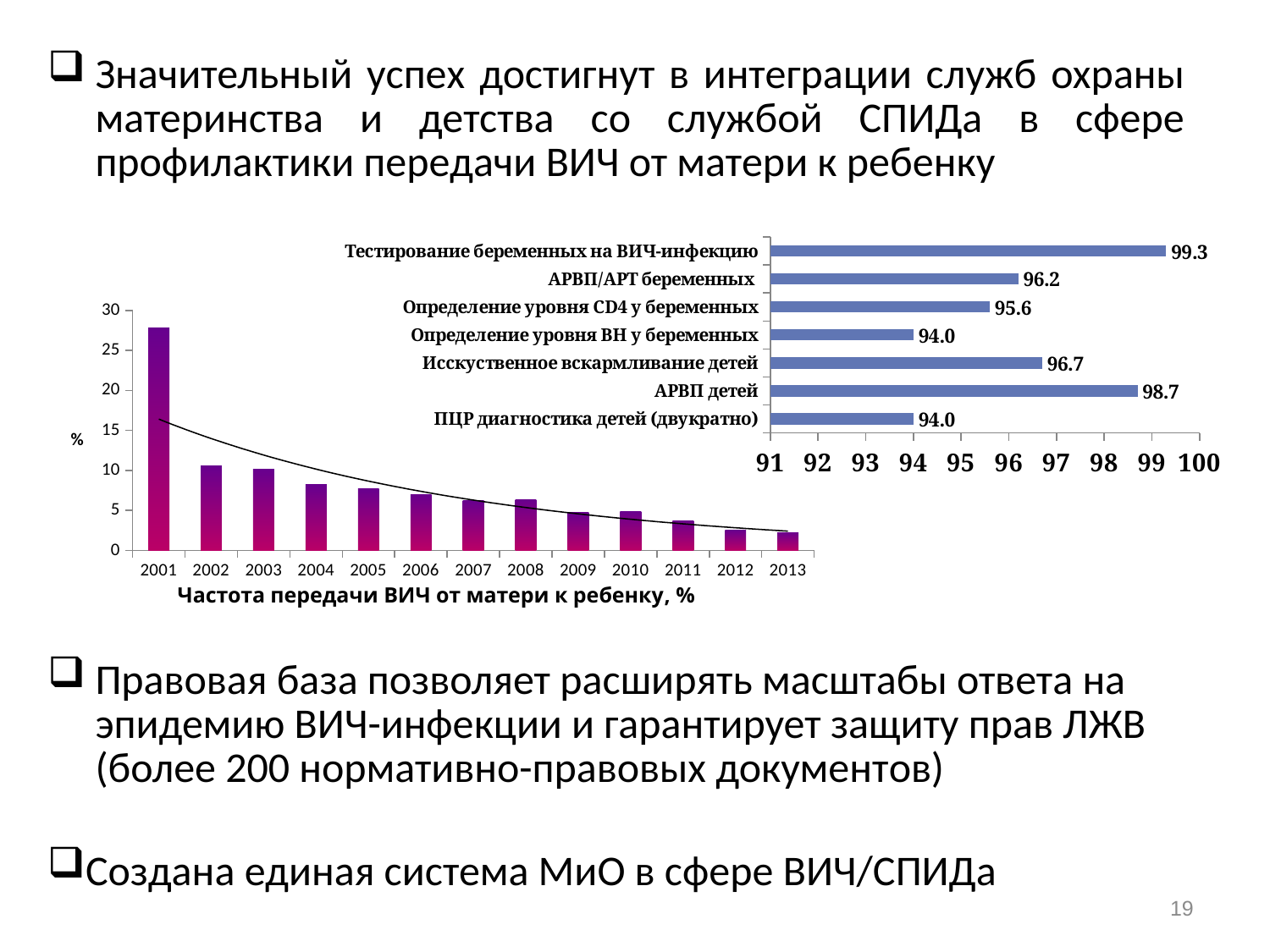
On the right chart, what is the value for АРВП детей? 98.7 On the chart titled Частота передачи ВИЧ от матери к ребенку, %, which year has the lowest value? 2013 On the chart titled Частота передачи ВИЧ от матери к ребенку, %, which year has the highest value? 2001 On the right chart, what is the difference between Тестирование беременных на ВИЧ-инфекцию and ПЦР диагностика детей (двукратно)? 5.3 On the right chart, which is larger: АРВП детей or АРВП/АРТ беременных? АРВП детей On the chart titled Частота передачи ВИЧ от матери к ребенку, %, how many years are shown on the x axis? 13 On the right chart, what is the value for Тестирование беременных на ВИЧ-инфекцию? 99.3 On the right chart, which category has the highest value? Тестирование беременных на ВИЧ-инфекцию On the chart titled Частота передачи ВИЧ от матери к ребенку, %, do the values rise or fall from 2001 to 2013? fall On the right chart, what is the value for Определение уровня CD4 у беременных? 95.6 On the right chart, how many categories are shown? 7 On the chart titled Частота передачи ВИЧ от матери к ребенку, %, is the value for 2001 greater or less than 25? greater